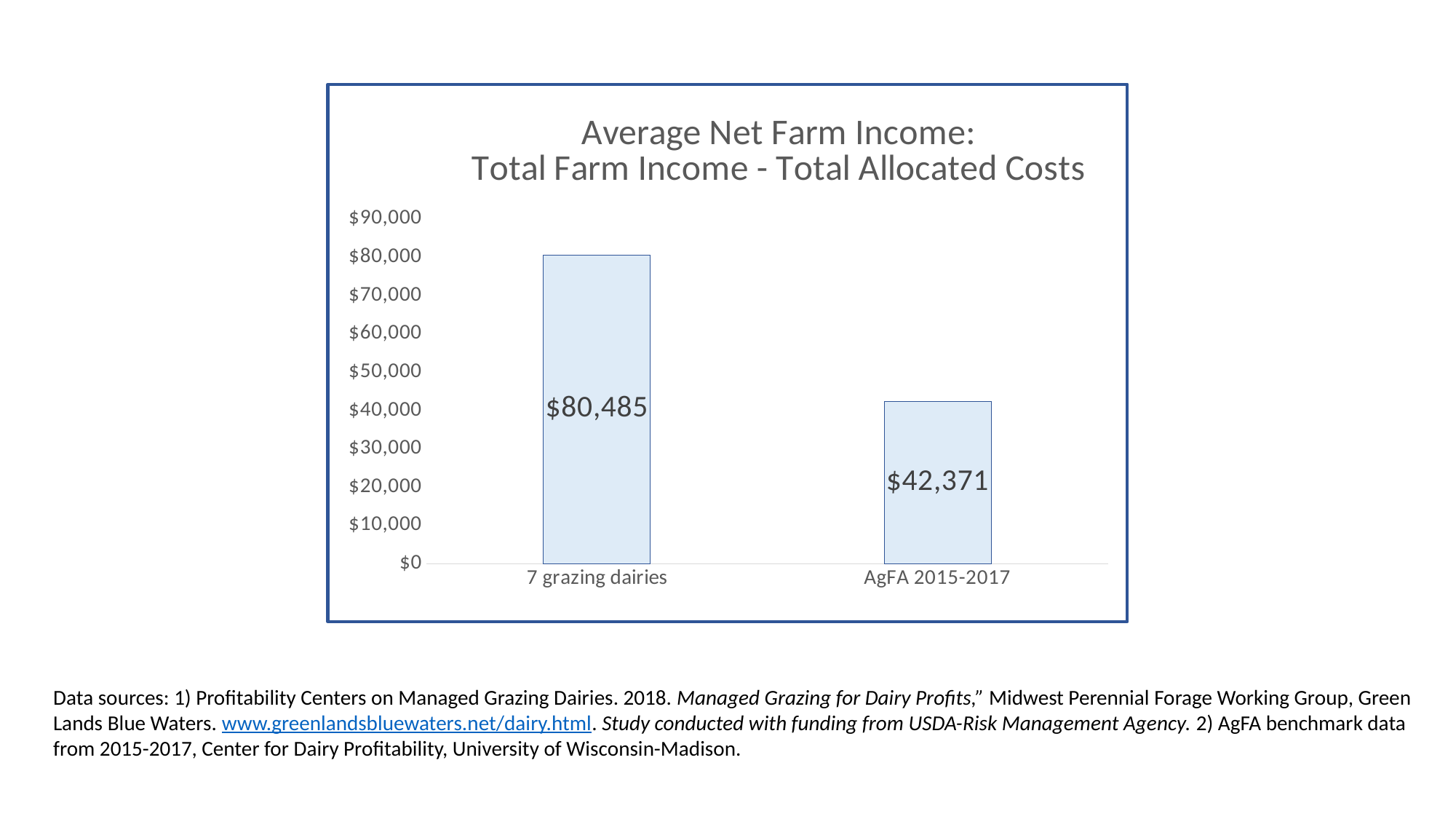
What kind of chart is shown on the slide? bar chart Is the average net farm income for the 7 grazing dairies larger or smaller than that for AgFA 2015-2017? larger Is the value for 7 grazing dairies greater or less than $70,000? greater What is the title of the chart? Average Net Farm Income: Total Farm Income - Total Allocated Costs What is the highest value shown on the vertical axis of the chart? $90,000 Which category has the lower average net farm income? AgFA 2015-2017 What is the difference in average net farm income between the 7 grazing dairies and AgFA 2015-2017? $38,114 Is the value for AgFA 2015-2017 greater or less than $50,000? less How many categories are shown on the chart? 2 What is the average net farm income for AgFA 2015-2017? $42,371 What is the average net farm income for the 7 grazing dairies? $80,485 Which category has the higher average net farm income? 7 grazing dairies